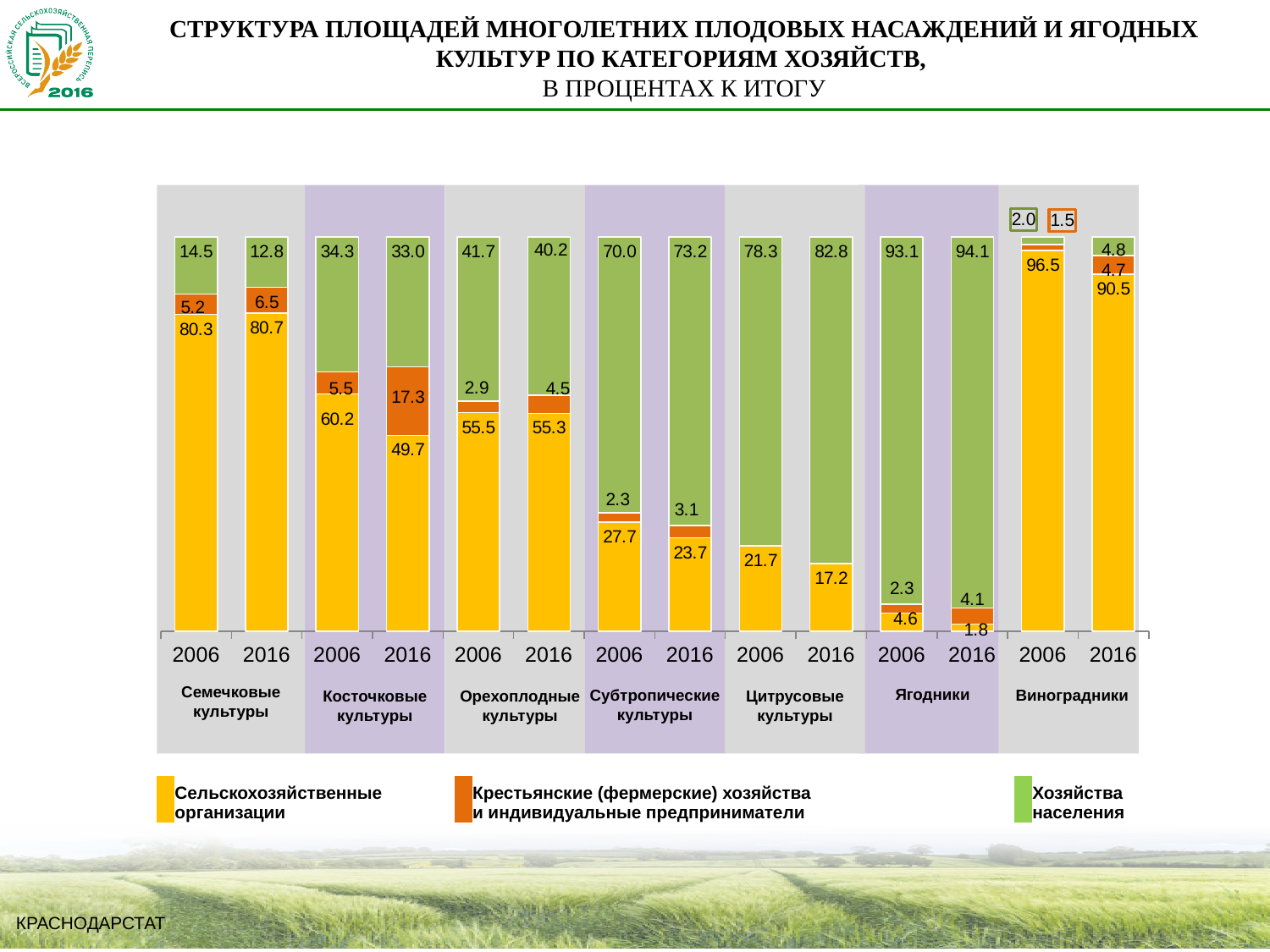
What share of the area of Виноградники belonged to Сельскохозяйственные организации in 2006? 96.5 How many series does the legend list? 3 Which colour represents Хозяйства населения in the chart? Green What share of the area of Ягодники belonged to Хозяйства населения in 2006? 93.1 Among the 2016 bars, which crop category has the highest share for Хозяйства населения? Ягодники What share of the area of Семечковые культуры belonged to Сельскохозяйственные организации in 2016? 80.7 What share of the area of Косточковые культуры belonged to Крестьянские (фермерские) хозяйства и индивидуальные предприниматели in 2016? 17.3 What type of chart is shown on the slide? Stacked bar chart Which is larger: the share of Хозяйства населения in Субтропические культуры in 2006 or in 2016? 2016 By how much did the share of Сельскохозяйственные организации in Косточковые культуры change from 2006 to 2016? 10.5 How many crop categories are shown on the chart? 7 Among the 2006 bars, which crop category has the lowest share for Сельскохозяйственные организации? Ягодники